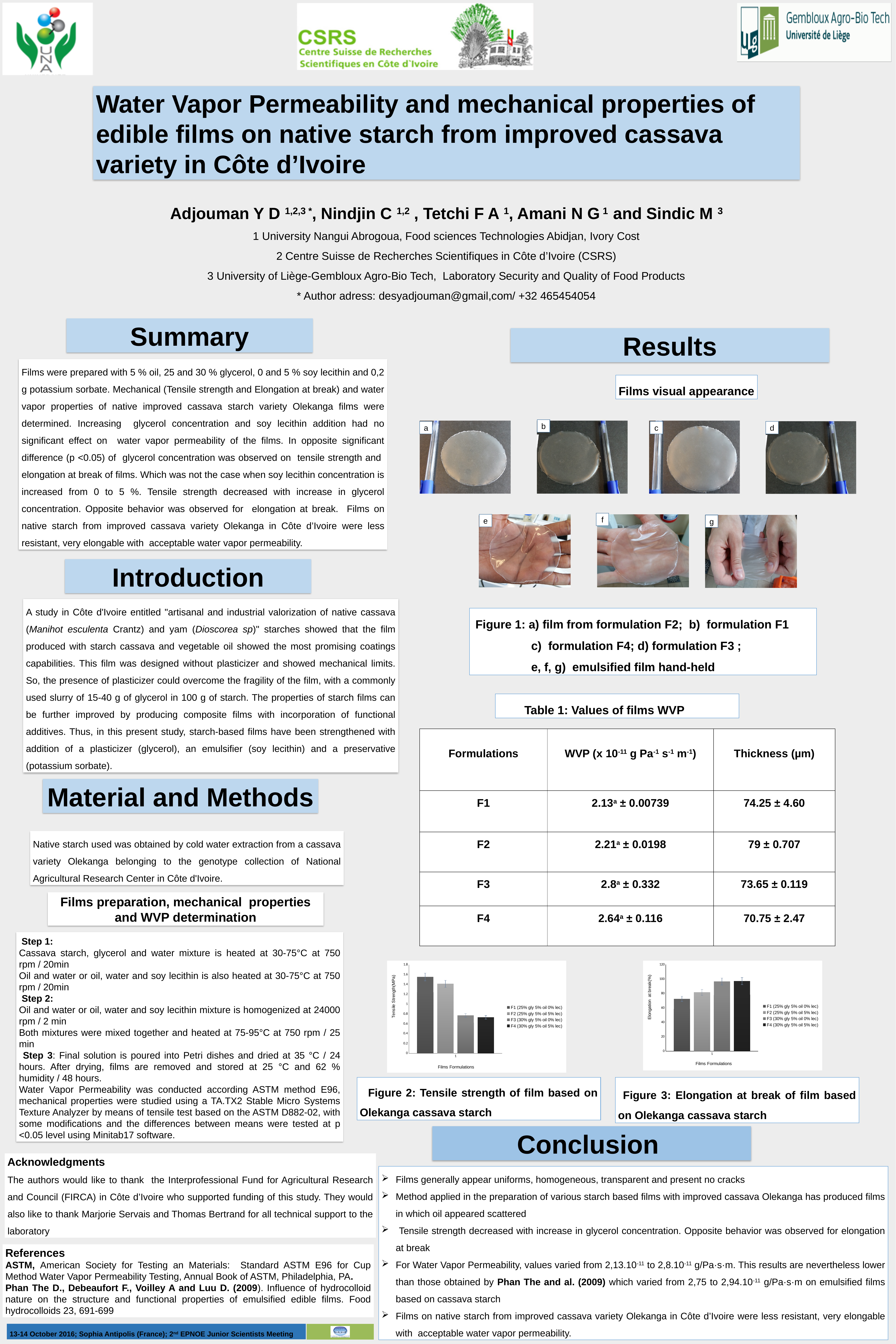
In Figure 3 (Elongation at break), which formulation has the lowest elongation at break? F1 (25% gly 5% oil 0% lec) In Figure 3 (Elongation at break), which is larger, the value for F1 or the value for F3? F3 In Figure 2 (Tensile strength), is the value for F1 greater or less than 1.4? greater How many series does the legend of Figure 3 (Elongation at break) list? 4 In Figure 2 (Tensile strength), which formulation has the highest tensile strength? F1 (25% gly 5% oil 0% lec) In Figure 2 (Tensile strength), is the value for F3 greater or less than 1.0? less In Figure 3 (Elongation at break), is the value for F1 greater or less than 80? less What kind of chart is Figure 2 (Tensile strength of film based on Olekanga cassava starch)? bar chart In Figure 2 (Tensile strength), which is larger, the value for F1 or the value for F3? F1 In Figure 2 (Tensile strength), do the bar values rise or fall going from F1 to F4? fall What is the y-axis label of Figure 3? Elongation at break(%)